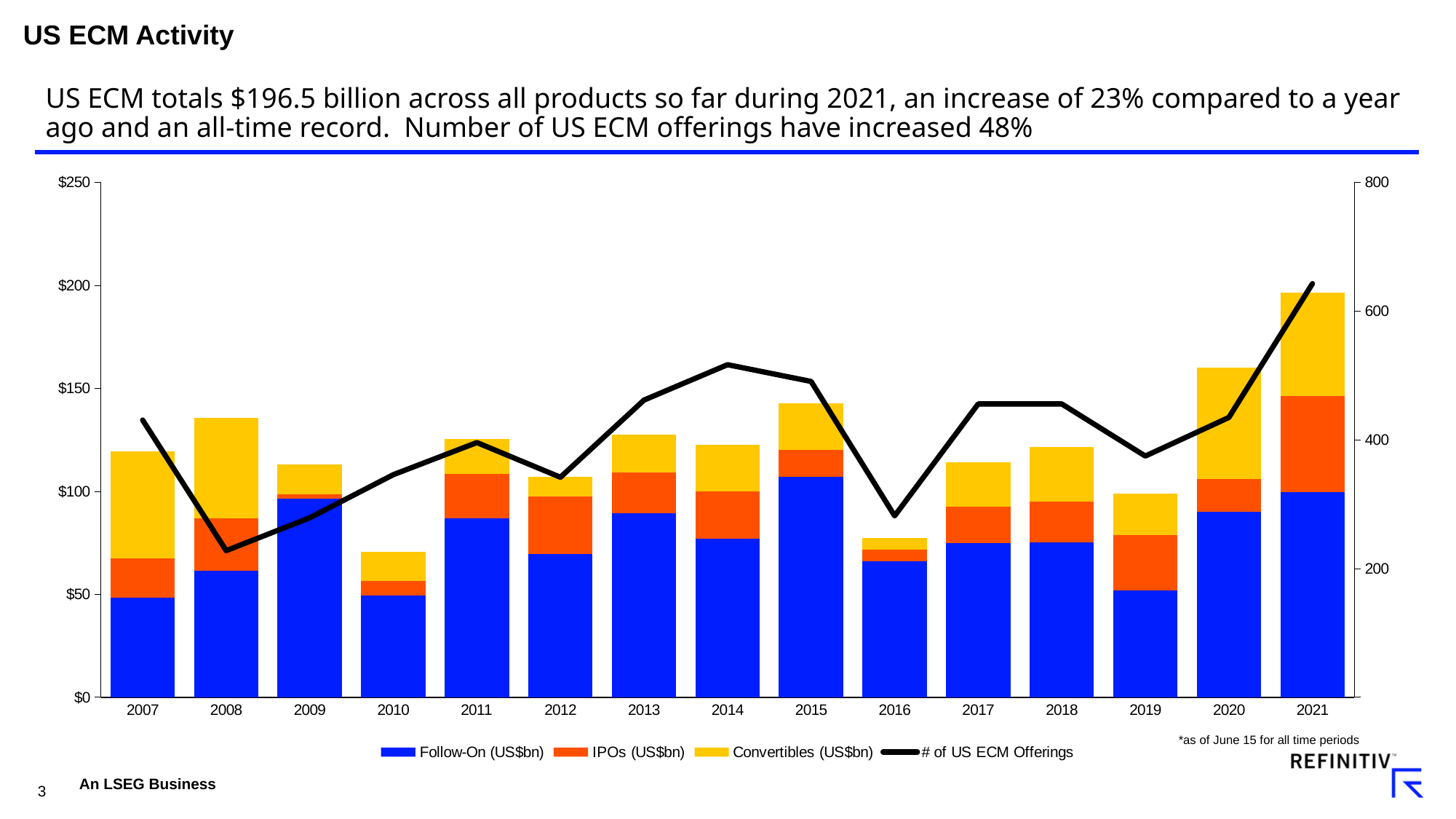
In which year does the # of US ECM Offerings line reach its lowest point? 2008 Which year has the tallest stacked bar? 2021 Is the total stacked bar value for 2021 greater or less than $150? greater In which year does the # of US ECM Offerings line reach its highest point? 2021 Do the total stacked bar values rise or fall from 2019 to 2021? rise Is the # of US ECM Offerings value for 2008 greater or less than 300? less Is the # of US ECM Offerings value for 2021 greater or less than 600? greater Which year has the larger total stacked bar, 2019 or 2020? 2020 What kind of chart is shown on the slide? Combined stacked bar and line chart How many years are shown on the x axis? 15 How many series does the legend list? 4